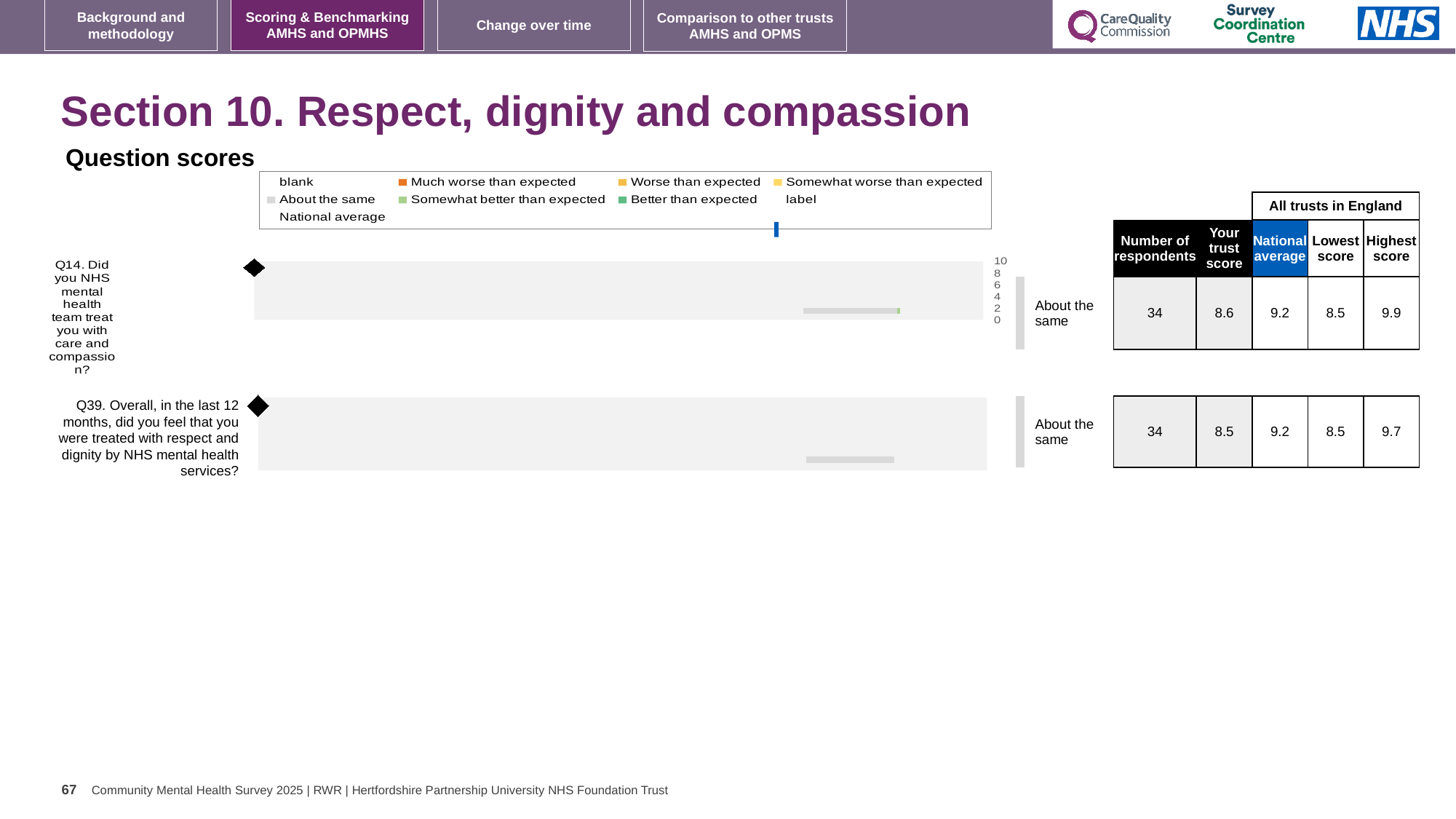
How many survey questions are plotted in the chart? 2 What benchmark category is shown next to the bar for Q39? About the same What is the heading above the National average, Lowest score and Highest score columns in the table? All trusts in England Which question has the higher trust score in the table, Q14 or Q39? Q14 In the table beside the chart, what is the national average for Q14? 9.2 What benchmark category is shown next to the bar for Q14? About the same In the table beside the chart, what is the trust score for Q39? 8.5 In the table beside the chart, what is the highest score for Q39? 9.7 What is the difference between the national average and the trust score for Q14 in the table? 0.6 In the table beside the chart, what is the trust score for Q14? 8.6 In the table beside the chart, how many respondents answered Q14? 34 What kind of chart is shown under "Question scores"? bar chart